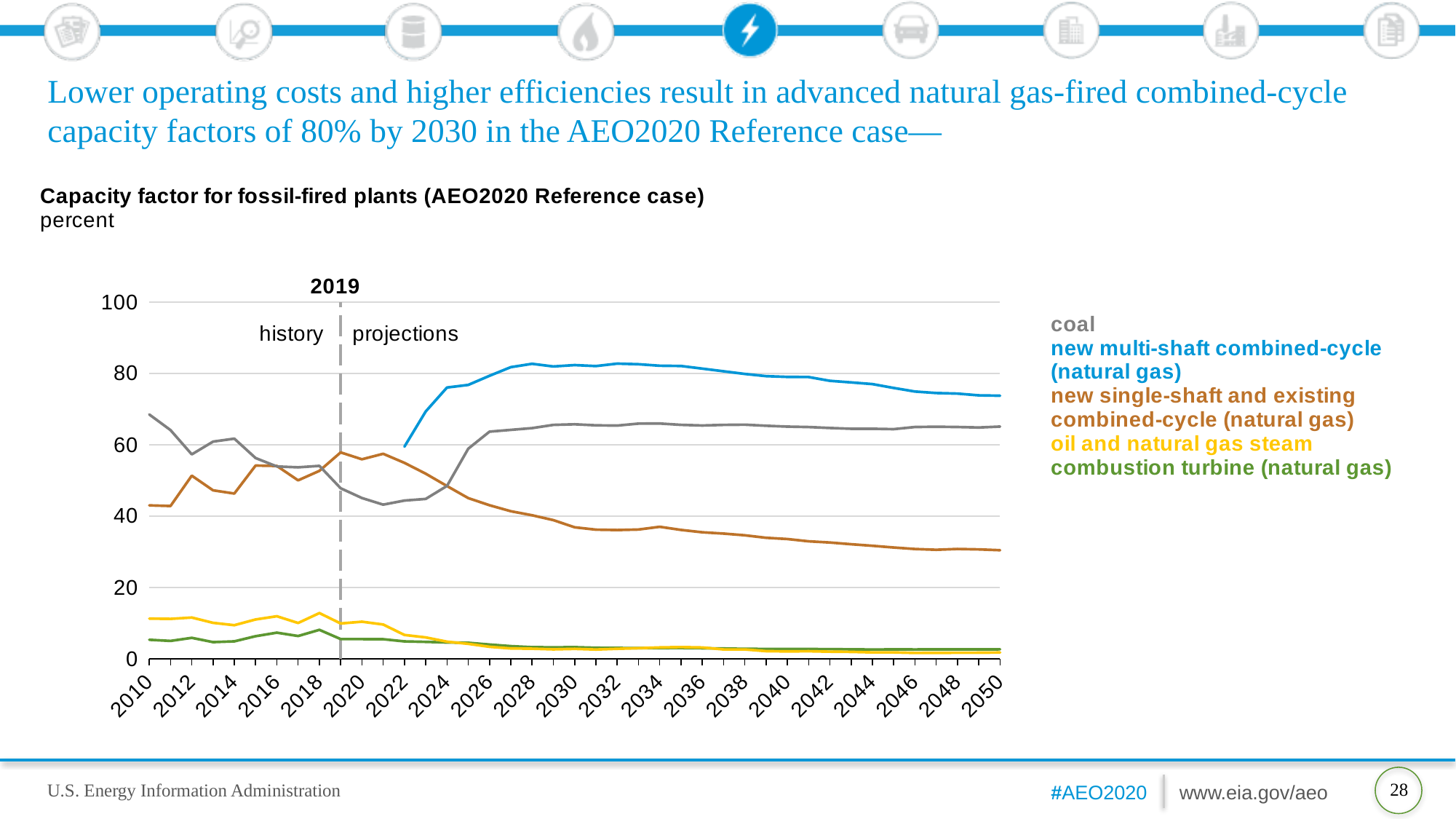
What kind of chart is shown on the slide? line chart Is the capacity factor for new multi-shaft combined-cycle (natural gas) in 2030 greater or less than 60? greater Is the capacity factor for oil and natural gas steam in 2010 greater or less than 20? less How many series does the legend list? 5 Which series has the lowest capacity factor in 2010? combustion turbine (natural gas) In 2050, which is larger: the capacity factor for coal or for new single-shaft and existing combined-cycle (natural gas)? coal Does the capacity factor for new single-shaft and existing combined-cycle (natural gas) rise or fall from 2020 to 2050? fall Is the capacity factor for new single-shaft and existing combined-cycle (natural gas) in 2050 greater or less than 40? less Which series has the highest capacity factor in 2050? new multi-shaft combined-cycle (natural gas) Which year does the dashed vertical line separating history from projections mark? 2019 What is the title of the chart? Capacity factor for fossil-fired plants (AEO2020 Reference case) Which series has the highest capacity factor in 2010? coal